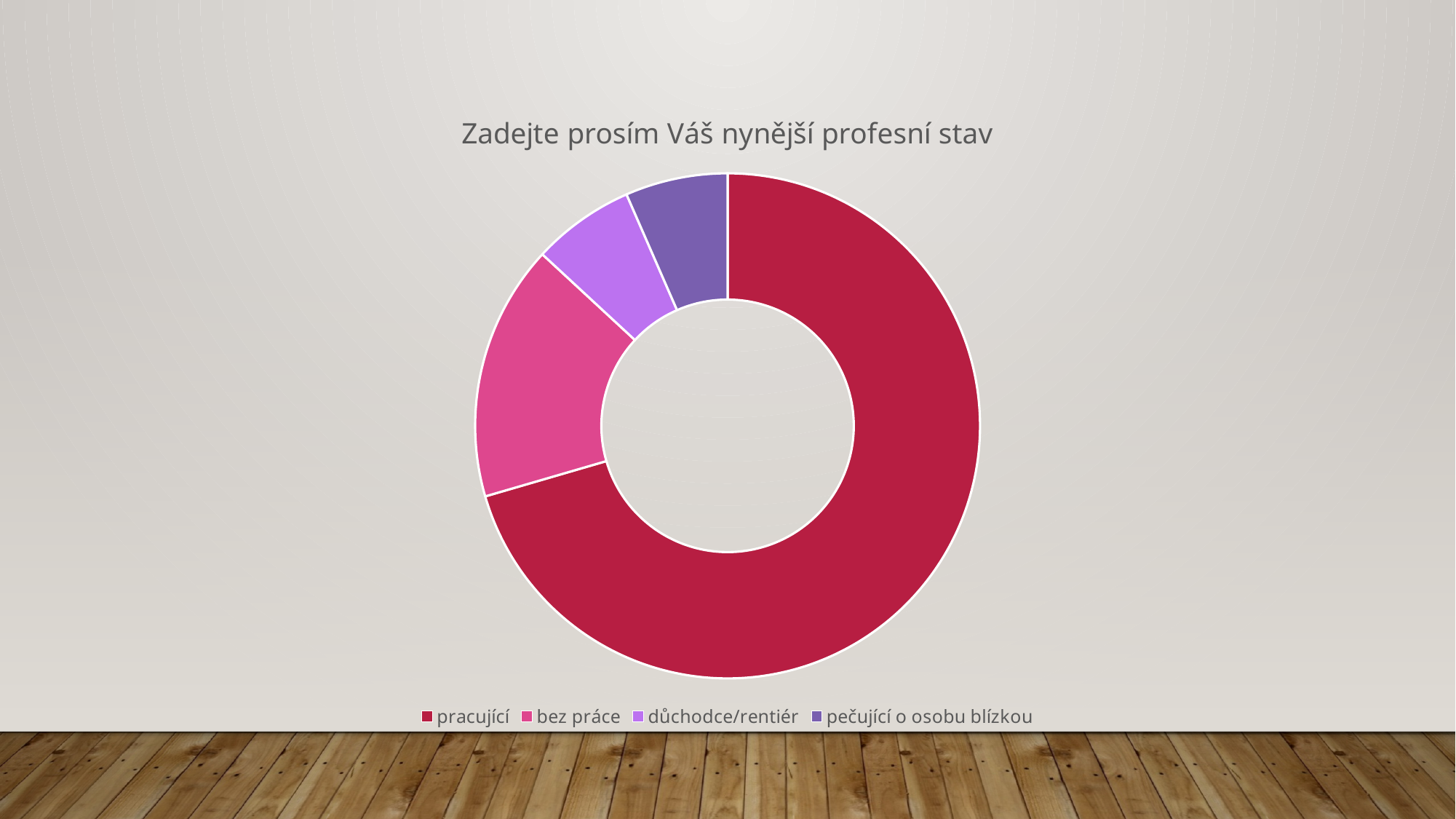
Which category is the second largest in the chart? bez práce What is the title of the chart? Zadejte prosím Váš nynější profesní stav Which is larger, the share for bez práce or the share for důchodce/rentiér? bez práce Which category has the largest share of the chart? pracující Is the share for pracující greater or less than half of the chart? greater Which is larger, the share for pracující or the share for bez práce? pracující Which category is shown in the dark red colour? pracující Which is larger, the share for bez práce or the share for pečující o osobu blízkou? bez práce What kind of chart is shown on the slide? Doughnut (pie) chart How many entries does the legend list? 4 How many categories does the chart show? 4